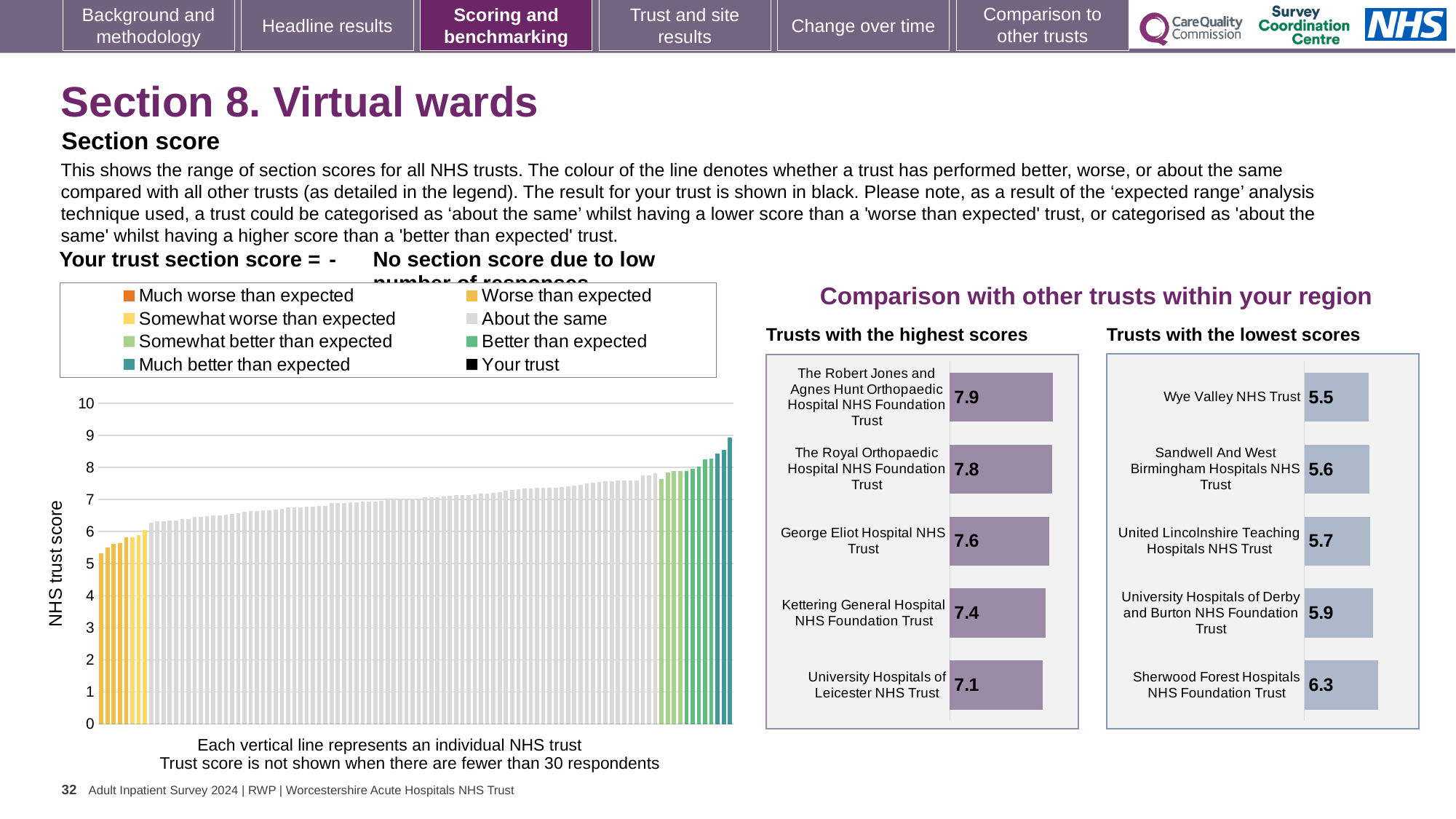
In the 'Trusts with the highest scores' chart, what is the score for The Robert Jones and Agnes Hunt Orthopaedic Hospital NHS Foundation Trust? 7.9 In the 'Trusts with the highest scores' chart, which trust has the highest score? The Robert Jones and Agnes Hunt Orthopaedic Hospital NHS Foundation Trust In the 'Trusts with the highest scores' chart, what is the difference between the scores of The Robert Jones and Agnes Hunt Orthopaedic Hospital NHS Foundation Trust and University Hospitals of Leicester NHS Trust? 0.8 In the NHS trust score chart on the left, is the value of the tallest bar greater or less than 8? greater What kind of chart is the NHS trust score chart on the left of the slide? Bar chart In the 'Trusts with the lowest scores' chart, which trust has the lowest score? Wye Valley NHS Trust How many trusts are shown in the 'Trusts with the lowest scores' chart? 5 In the NHS trust score chart on the left, do the values rise or fall from left to right? Rise In the 'Trusts with the highest scores' chart, which has the higher score: George Eliot Hospital NHS Trust or Kettering General Hospital NHS Foundation Trust? George Eliot Hospital NHS Trust How many entries does the legend of the NHS trust score chart on the left list? 8 In the 'Trusts with the lowest scores' chart, what is the score for Sherwood Forest Hospitals NHS Foundation Trust? 6.3 In the 'Trusts with the lowest scores' chart, what is the score for Wye Valley NHS Trust? 5.5